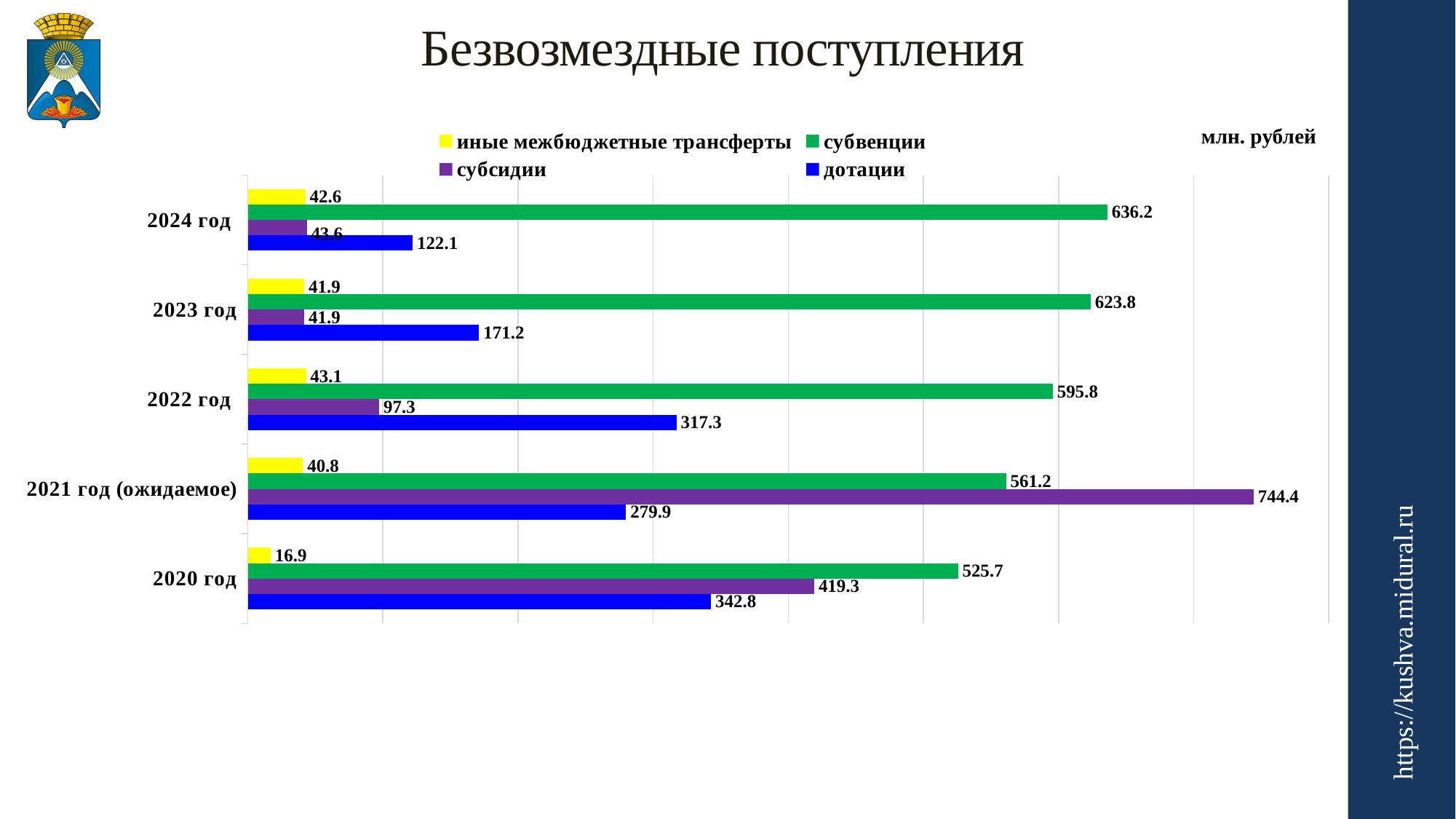
How many years are shown on the chart? 5 What is the value of дотации for 2022 год? 317.3 What unit of measurement is indicated on the chart? млн. рублей What is the value of иные межбюджетные трансферты for 2020 год? 16.9 How many series does the legend list? 4 Which is larger for 2020 год: субсидии or дотации? субсидии What type of chart is shown on the slide? bar chart Which year has the highest value for субвенции? 2024 год What is the value of субсидии for 2021 год (ожидаемое)? 744.4 Which year has the lowest value for дотации? 2024 год What is the difference between субвенции in 2024 год and 2023 год? 12.4 What is the value of субвенции for 2024 год? 636.2